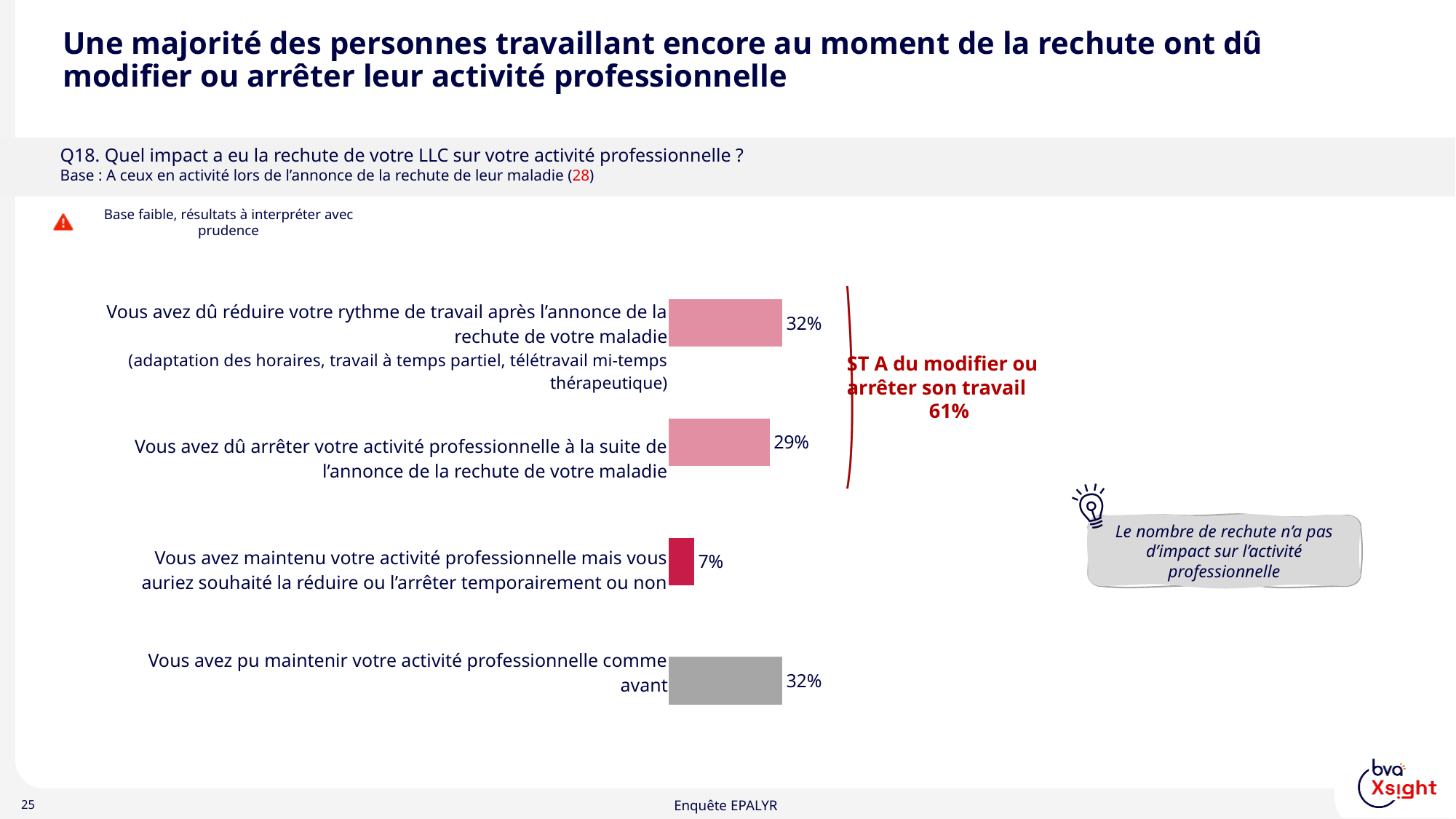
How many response categories are shown in the chart? 4 What is the difference in percentage points between those who maintained their activity as before (32%) and those who maintained it but would have liked to reduce or stop it (7%)? 25 percentage points What percentage maintained their professional activity but would have liked to reduce or stop it? 7% Which category has the lowest value in the chart? Vous avez maintenu votre activité professionnelle mais vous auriez souhaité la réduire ou l'arrêter temporairement ou non Which is larger: the share who had to stop their professional activity or the share who maintained it but would have liked to reduce or stop it? The share who had to stop their professional activity (29%) What percentage were able to maintain their professional activity as before ("comme avant")? 32% What colour is the bar for the category "Vous avez pu maintenir votre activité professionnelle comme avant"? Grey What is the difference in percentage points between those who had to reduce their work rhythm (32%) and those who had to stop their professional activity (29%)? 3 percentage points What is the combined percentage shown for the subtotal "ST A du modifier ou arrêter son travail"? 61% What type of chart is shown on the slide? Bar chart What percentage of respondents had to stop their professional activity following the relapse announcement ("Vous avez dû arrêter votre activité professionnelle")? 29% What percentage of respondents had to reduce their work rhythm after the announcement of the relapse ("Vous avez dû réduire votre rythme de travail")? 32%